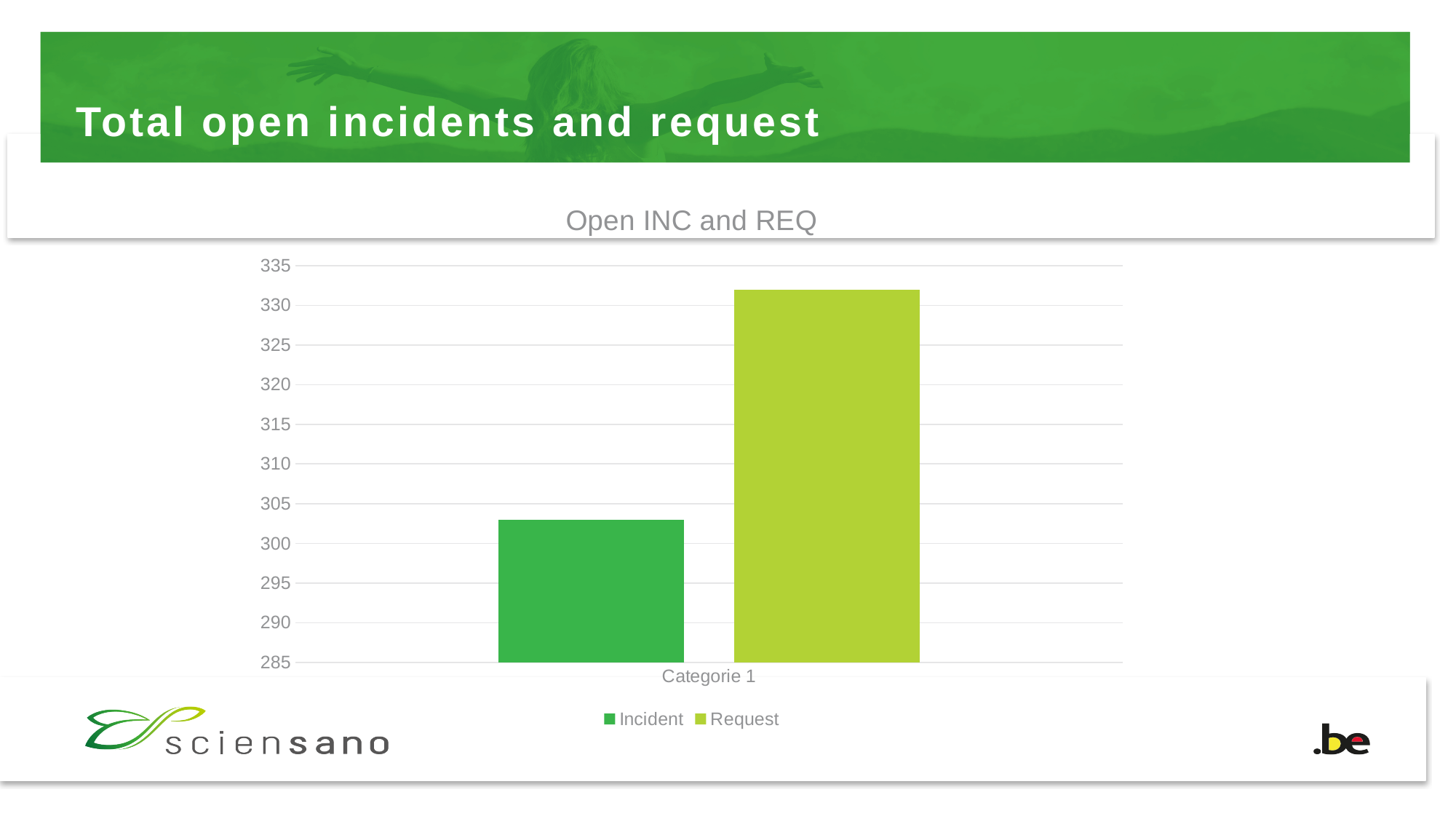
How many series does the legend list? 2 Which series has the highest value? Request Is the value for Incident greater or less than 305? less Which is larger, the value for Incident or the value for Request? Request What kind of chart is shown on the slide? bar chart What is the title of the chart? Open INC and REQ What is the label of the category on the x axis? Categorie 1 Is the value for Request greater or less than 330? greater Is the value for Incident greater or less than 300? greater How many categories are shown on the x axis? 1 Which series has the lowest value? Incident